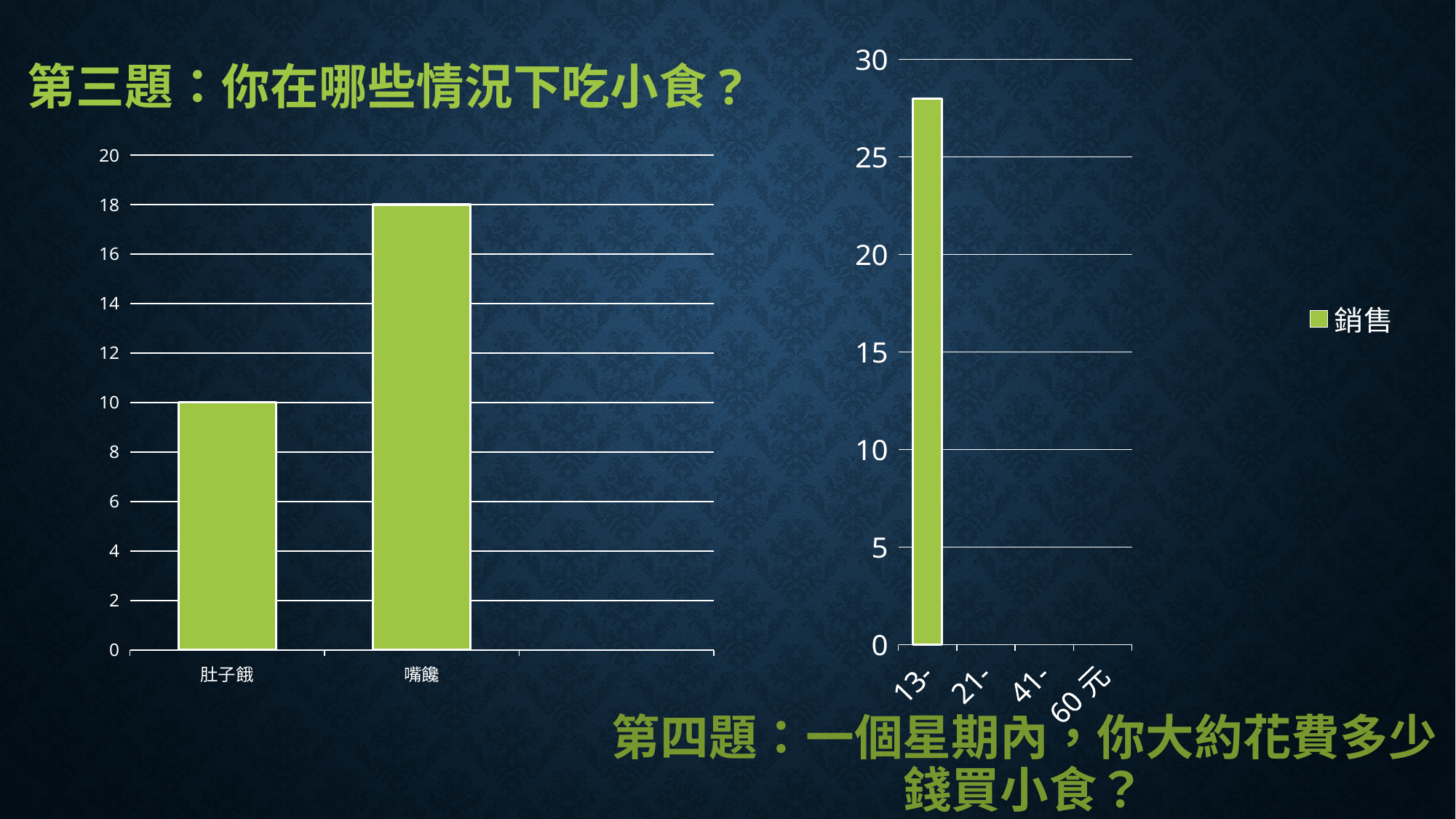
In the left chart (第三題), which category has the lowest value? 肚子餓 What kind of chart is the left chart (第三題)? bar chart In the left chart (第三題), what is the value for 嘴饞? 18 In the right chart (第四題), how many categories are shown on the x axis? 4 In the left chart (第三題), how many categories are shown on the x axis? 2 In the right chart (第四題), is the value for 13- greater or less than 25? greater In the left chart (第三題), what is the difference between the values for 嘴饞 and 肚子餓? 8 In the right chart (第四題), how many series does the legend list? 1 In the left chart (第三題), which category has the highest value? 嘴饞 In the right chart (第四題), what is the name of the series shown in the legend? 銷售 In the right chart (第四題), which category has the highest value? 13- In the left chart (第三題), what is the value for 肚子餓? 10